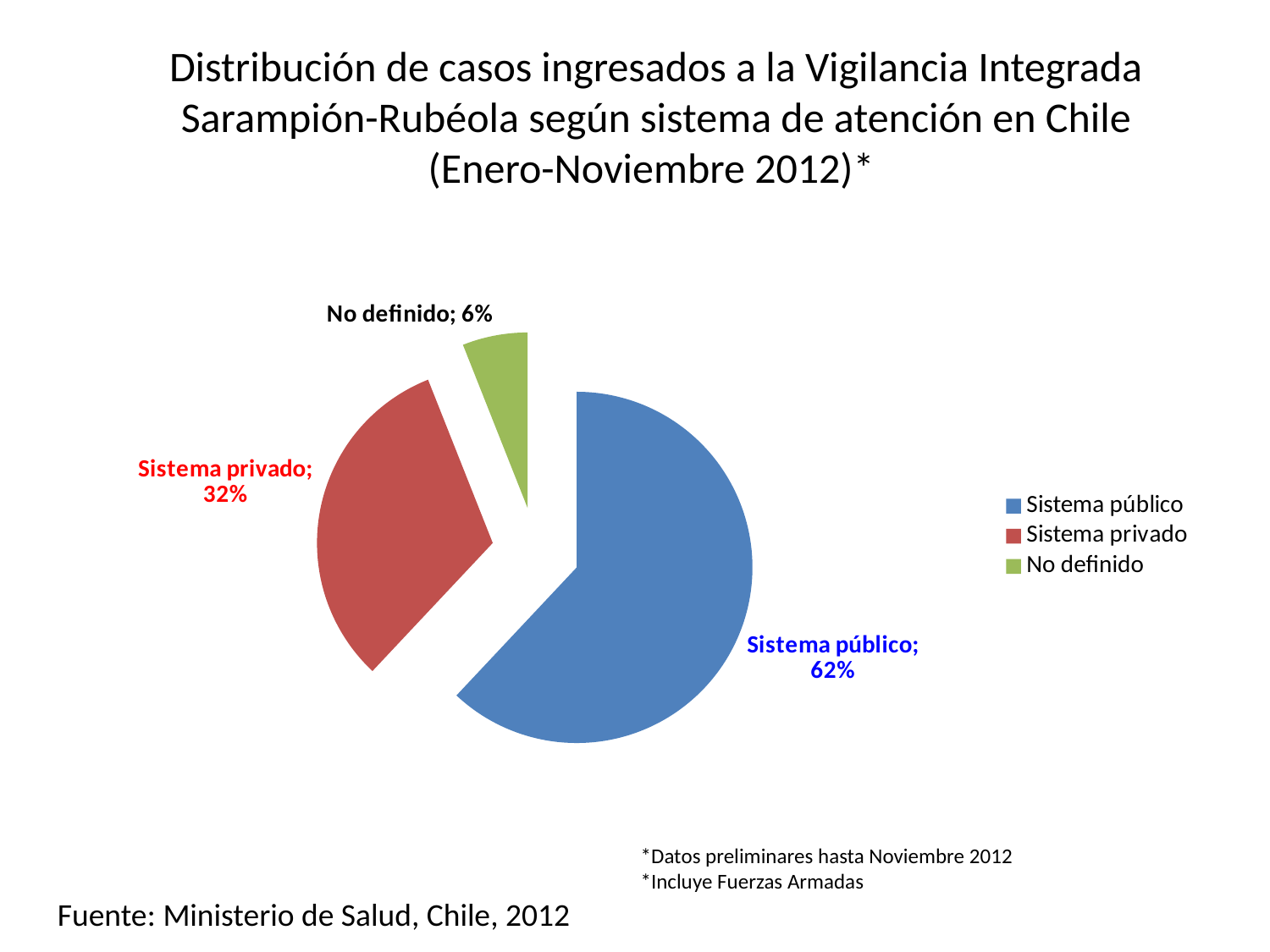
What is the value shown for No definido? 6% What is the difference between the shares of Sistema privado and No definido? 26% Which is larger, the share for Sistema privado or the share for No definido? Sistema privado What share of the pie does Sistema privado represent? 32% How many categories does the pie chart have? 3 What colour is the slice for Sistema privado? red What kind of chart is shown on the slide? pie chart What share of the pie does Sistema público represent? 62% Which category has the smallest slice of the pie? No definido How many entries does the legend list? 3 What is the difference between the shares of Sistema público and Sistema privado? 30% Which category has the largest slice of the pie? Sistema público